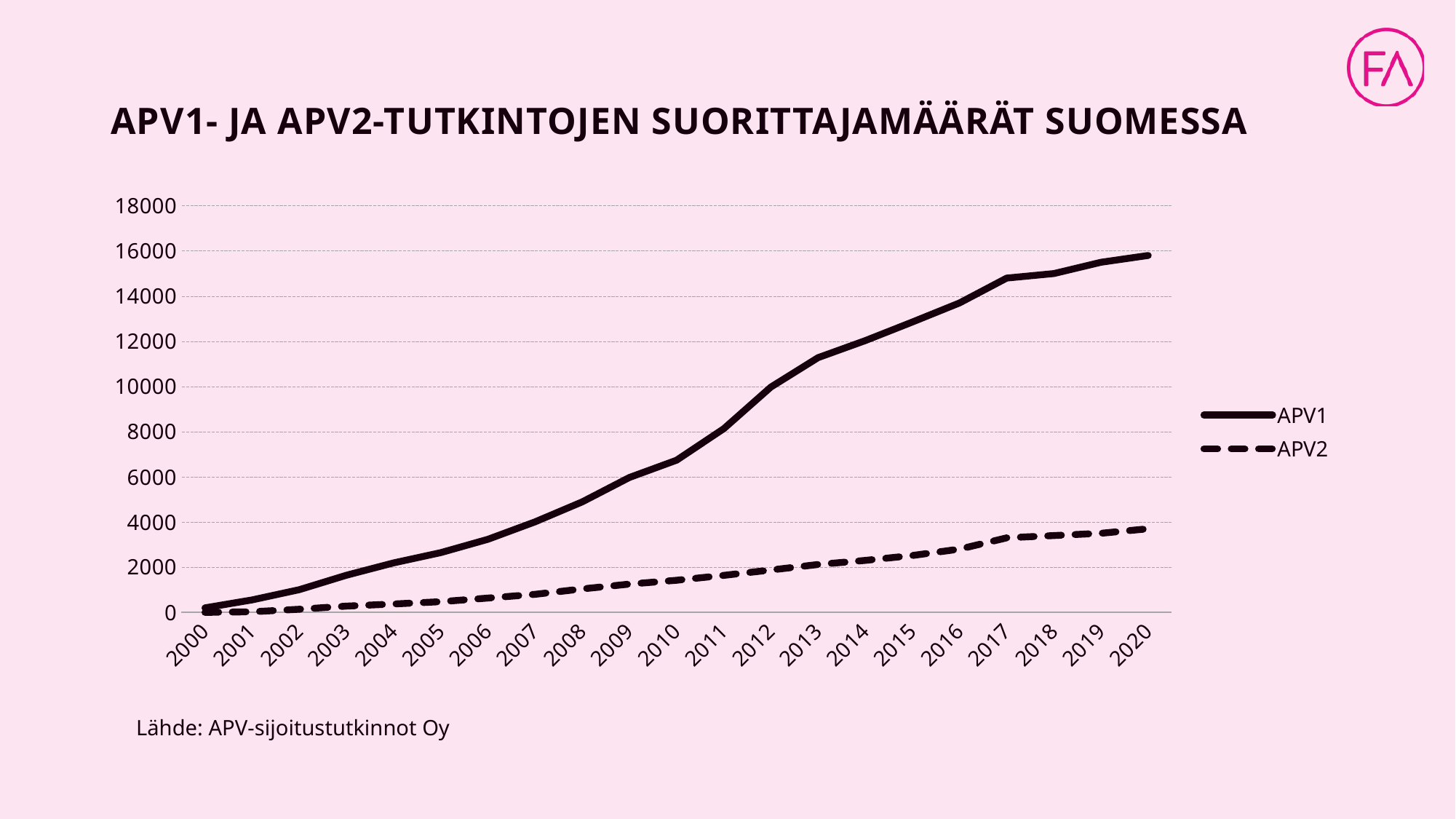
How many series does the legend list? 2 What kind of chart is shown on the slide? line chart Which series has the larger value in 2015, APV1 or APV2? APV1 Is the APV2 value for 2010 greater or less than 2000? less In which year is the APV1 value highest? 2020 Is the APV1 value for 2020 greater or less than 14000? greater Which series is drawn with a dashed line? APV2 Is the APV1 value for 2010 greater or less than 6000? greater In which year is the APV2 value lowest? 2000 How many years are shown on the x axis? 21 Do the APV1 values rise or fall from 2000 to 2020? rise